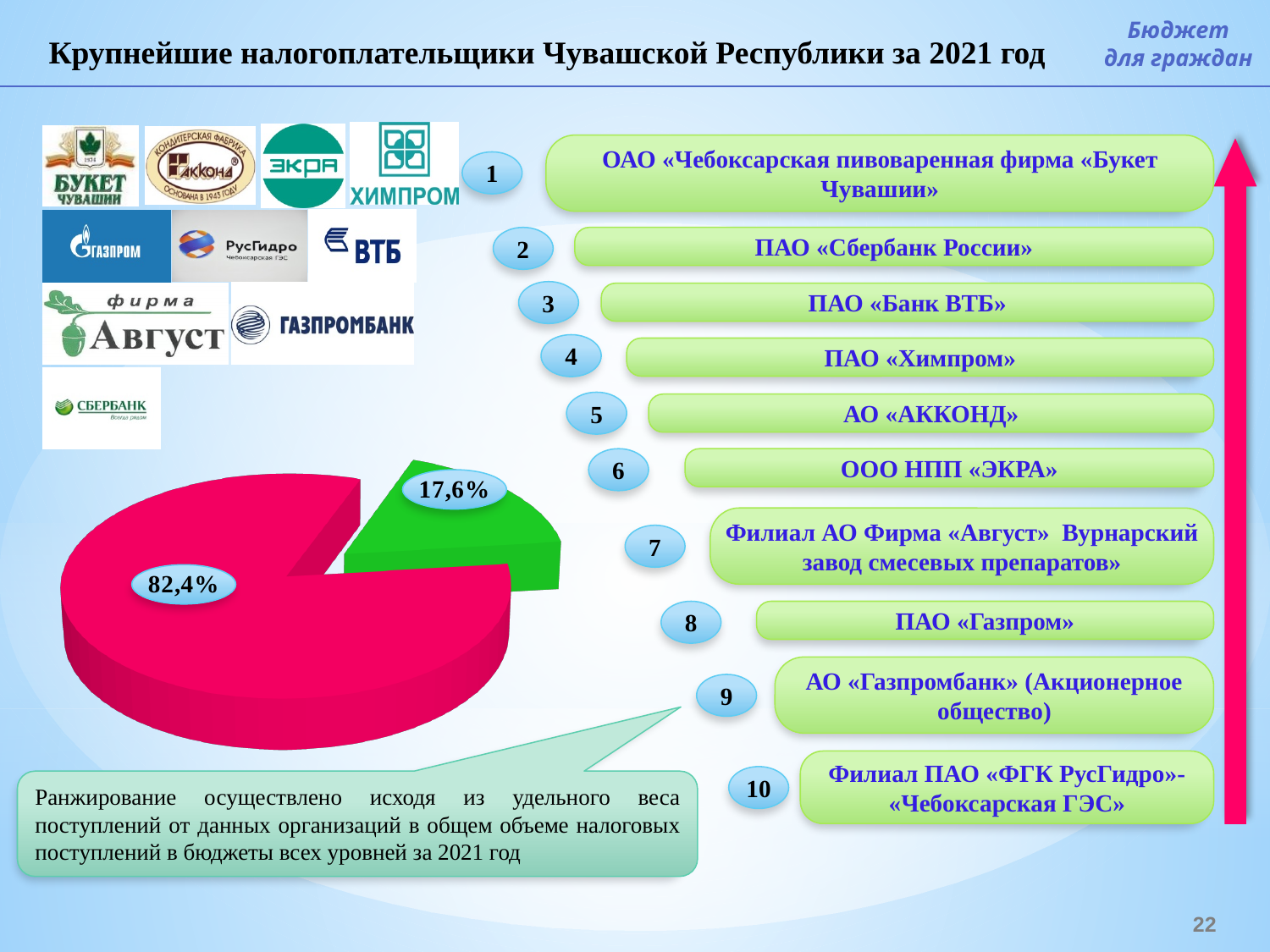
What colour is the slice of the pie chart that is pulled out from the rest? green What kind of chart is shown on the slide? pie chart Is the value of the pink slice of the pie chart greater or less than 80%? greater Is the value of the green slice of the pie chart greater or less than 20%? less What value is shown on the green slice of the pie chart? 17,6% What do the two slices of the pie chart add up to? 100% What value is shown on the pink slice of the pie chart? 82,4% How many slices does the pie chart have? 2 Which slice of the pie chart is the smallest? the green slice (17,6%) What is the difference between the pink slice and the green slice of the pie chart? 64,8% Which is larger in the pie chart, the pink slice or the green slice? the pink slice Which slice of the pie chart is the largest? the pink slice (82,4%)